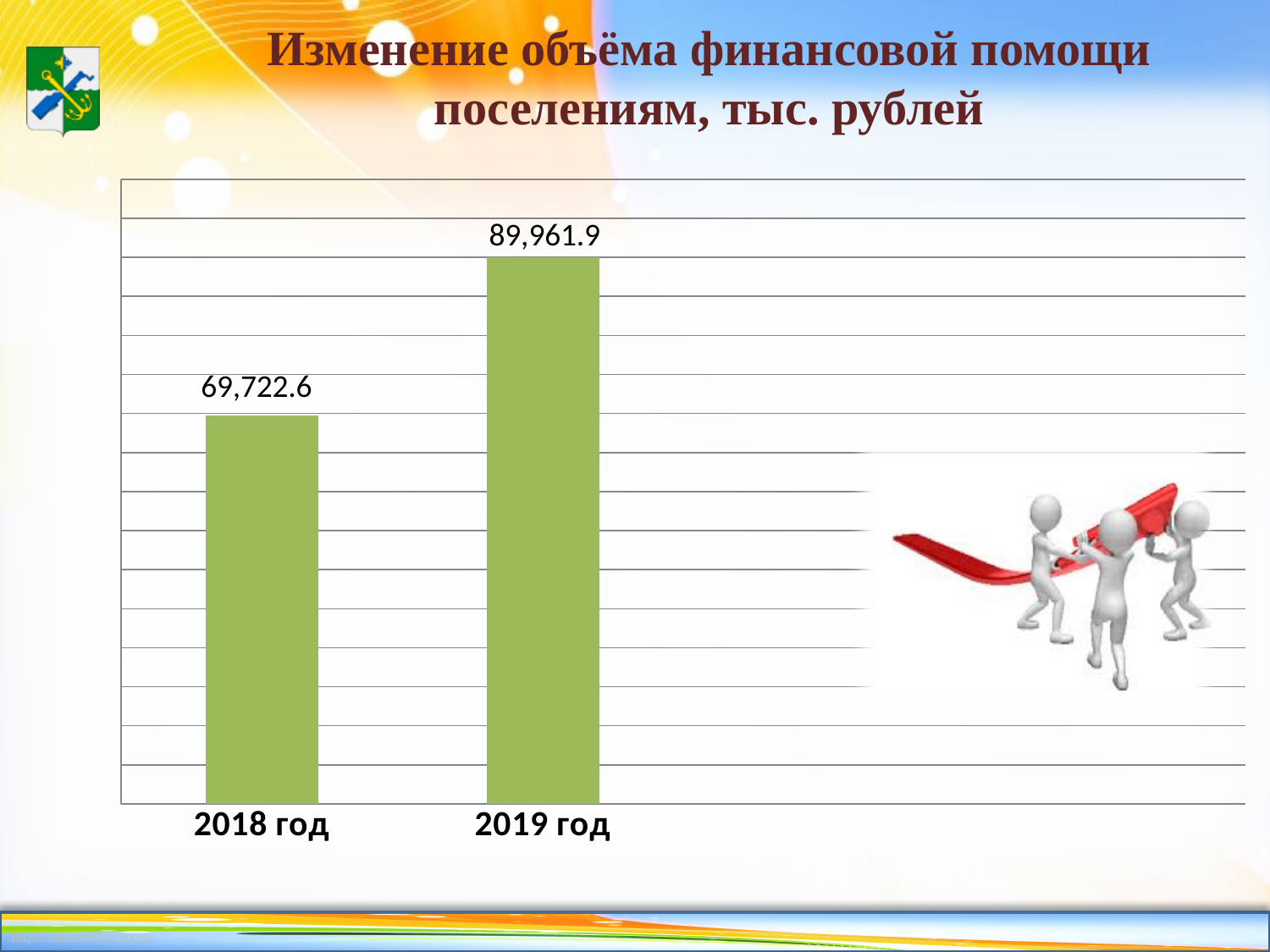
Which year has the highest value? 2019 год What kind of chart is shown on the slide? Bar chart What is the title of the chart? Изменение объёма финансовой помощи поселениям, тыс. рублей Which year has the lowest value? 2018 год Do the values rise or fall from 2018 год to 2019 год? Rise Which is larger, the value for 2018 год or the value for 2019 год? 2019 год What is the difference between the values for 2019 год and 2018 год? 20,239.3 What is the value for 2019 год? 89,961.9 What colour are the bars in the chart? Green What is the value for 2018 год? 69,722.6 How many categories are shown on the chart? 2